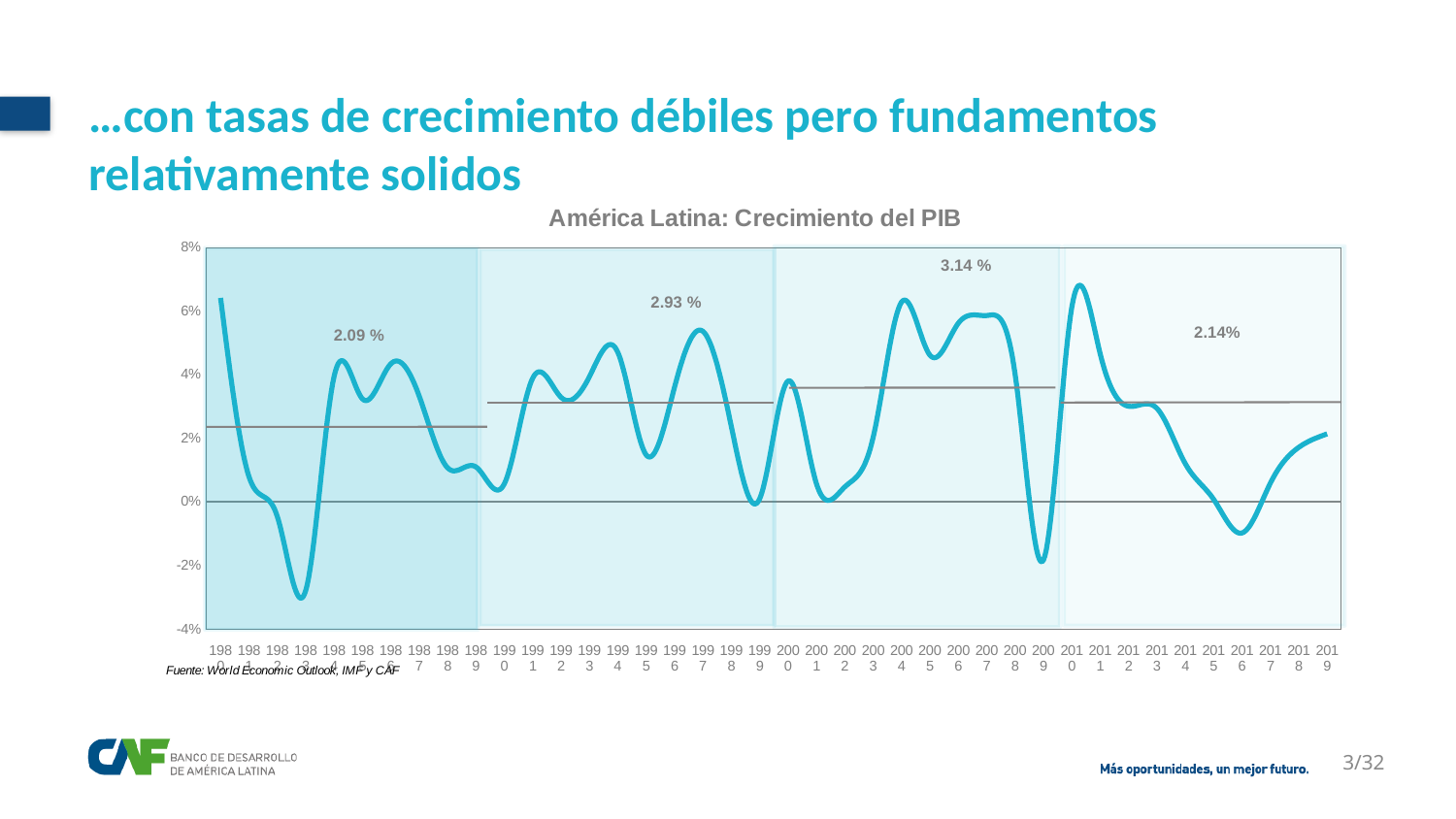
What average growth rate is labelled for the 2000s period (third shaded region)? 3.14 % How many shaded decade periods with labelled averages are shown on the chart? 4 Which labelled average is larger, the 1990s or the 2010s? 1990s (2.93 %) What is the title of the chart? América Latina: Crecimiento del PIB Which decade period has the lowest labelled average growth rate? 1980s (2.09 %) What average growth rate is labelled for the 1990s period (second shaded region)? 2.93 % What is the difference between the labelled average for the 2000s (3.14 %) and the 1980s (2.09 %)? 1.05 percentage points Is the GDP growth value for 1983 greater or less than -2%? less What kind of chart is shown on the slide? line chart What average growth rate is labelled for the 1980s period (first shaded region)? 2.09 % Which decade period has the highest labelled average growth rate? 2000s (3.14 %) What average growth rate is labelled for the 2010s period (fourth shaded region)? 2.14%